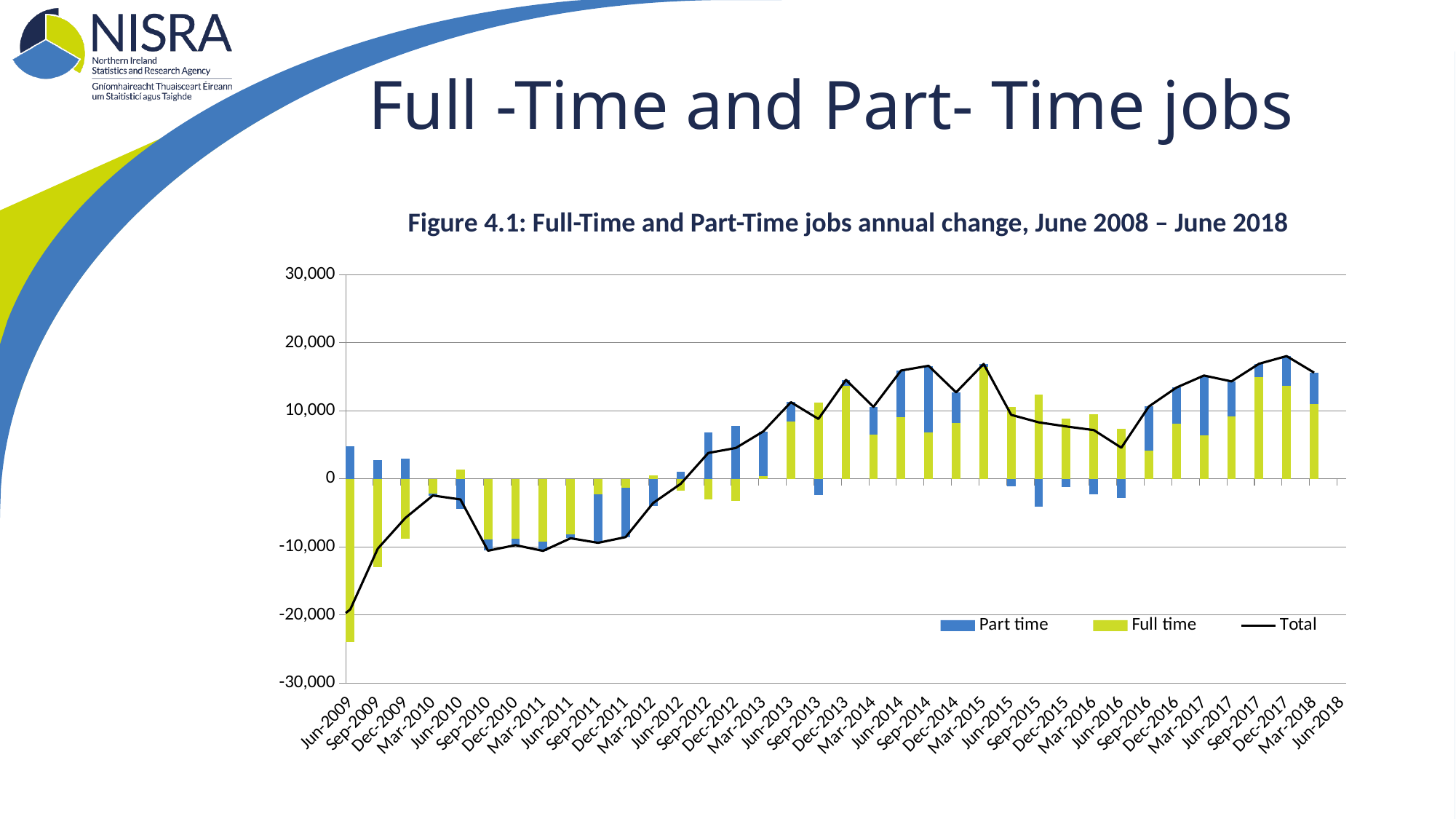
Is the Total value for Jun-2009 greater or less than -10,000? less What are the three series named in the legend of Figure 4.1? Part time, Full time, Total What kind of chart is shown in Figure 4.1? A bar chart with a line In which quarter is the Total line at its lowest value? Jun-2009 Which colour represents the Full time series in Figure 4.1? Yellow-green In which quarter is the Total line at its highest value? Dec-2017 Is the Total value for Dec-2017 greater or less than 10,000? greater How many quarterly categories are shown on the x axis of Figure 4.1? 37 Is the Full time value for Jun-2009 greater or less than -20,000? less How many series does the legend of Figure 4.1 list? 3 Does the Total line rise or fall between Jun-2009 and Mar-2010? rise